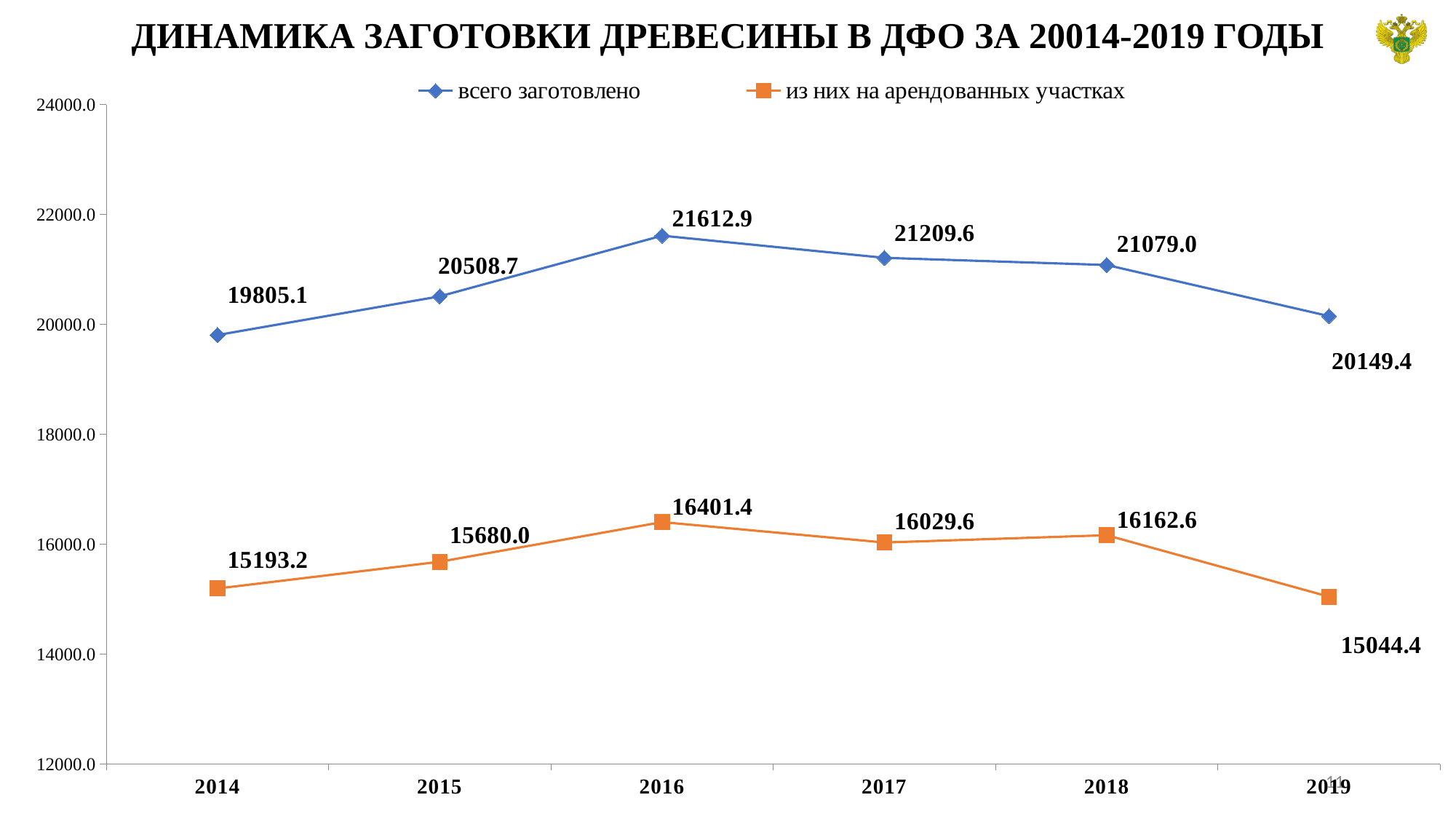
Does "всего заготовлено" rise or fall from 2014 to 2016? rise In which year is "из них на арендованных участках" lowest? 2019 How many years are shown on the x axis? 6 What is the difference between "всего заготовлено" and "из них на арендованных участках" in 2018? 4916.4 How many series does the legend list? 2 Which is larger for "из них на арендованных участках": the value in 2017 or in 2018? 2018 Is the value of "всего заготовлено" in 2019 greater or less than 20000.0? greater What is the value of "всего заготовлено" in 2014? 19805.1 In which year is "всего заготовлено" highest? 2016 What is the value of "из них на арендованных участках" in 2019? 15044.4 What is the value of "всего заготовлено" in 2016? 21612.9 What kind of chart is shown on the slide? line chart